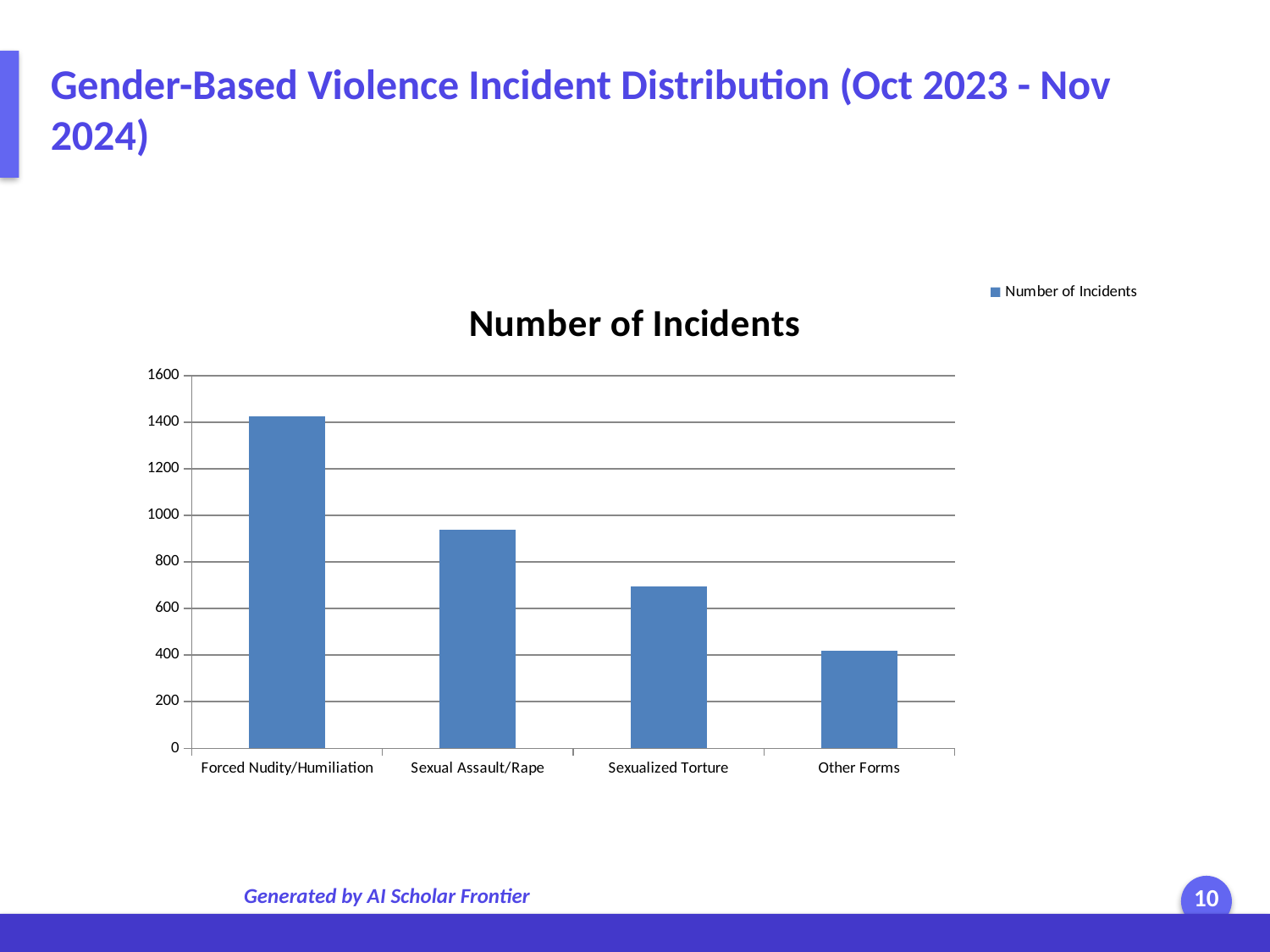
How many categories are shown on the x axis of the chart? 4 Which category has the lowest number of incidents? Other Forms Do the values rise or fall moving from left to right along the x axis? fall Is the value for Sexual Assault/Rape greater or less than 1000? less Which is larger, the value for Sexual Assault/Rape or the value for Sexualized Torture? Sexual Assault/Rape What is the title of the chart? Number of Incidents Is the value for Sexualized Torture greater or less than 600? greater Is the value for Other Forms greater or less than 600? less What kind of chart is shown on the slide? bar chart How many series does the chart legend list? 1 Which category has the highest number of incidents? Forced Nudity/Humiliation